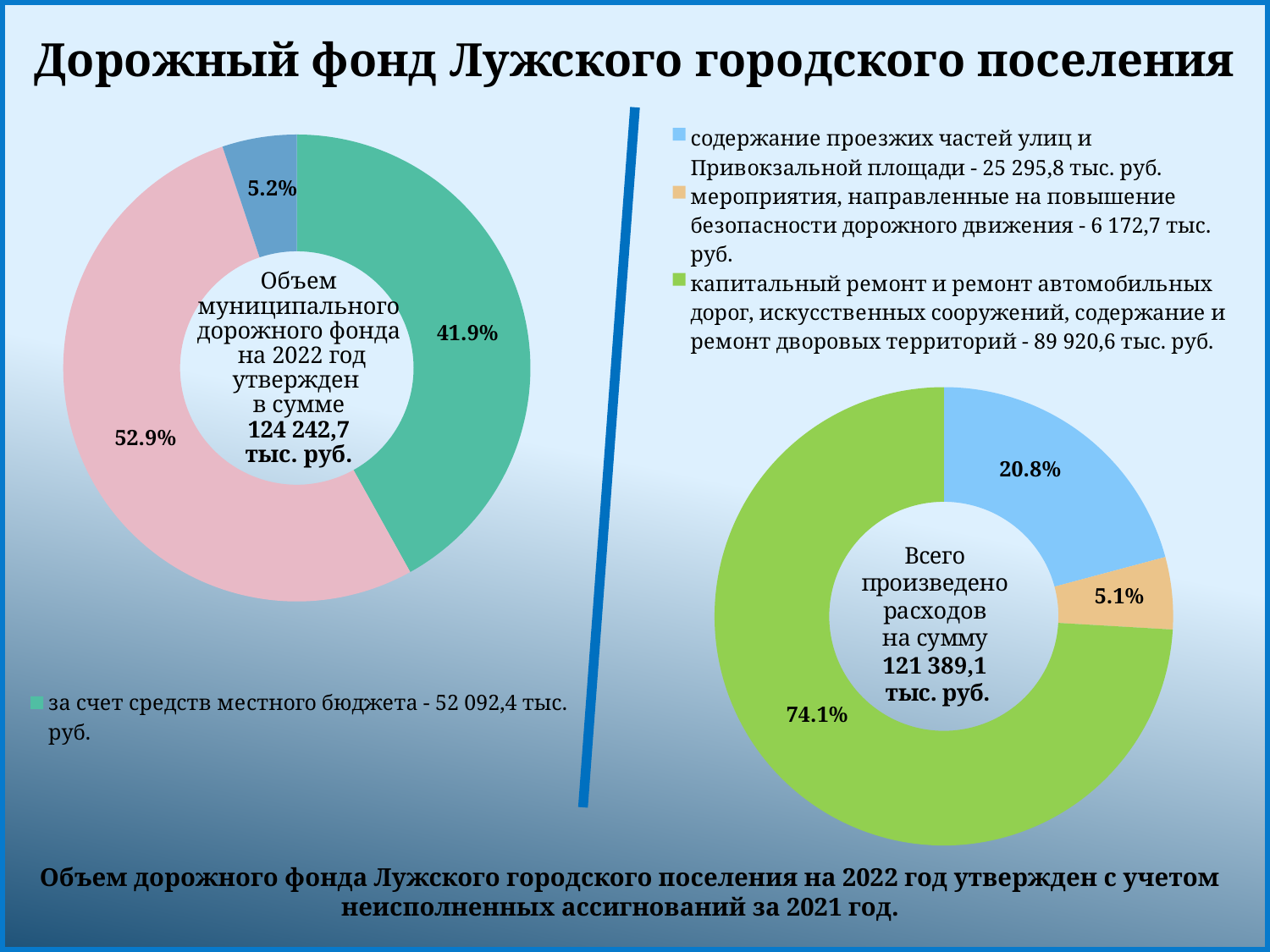
On the right chart (Всего произведено расходов), how many categories does the legend list? 3 On the right chart, what total amount of expenditures is shown in the centre of the chart? 121 389,1 тыс. руб. On the right chart (Всего произведено расходов), by how many percentage points does the share for капитальный ремонт exceed the share for содержание проезжих частей улиц и Привокзальной площади? 53.3 percentage points On the right chart (Всего произведено расходов), which category has the smallest share? мероприятия, направленные на повышение безопасности дорожного движения On the right chart (Всего произведено расходов), what share goes to мероприятия, направленные на повышение безопасности дорожного движения? 5.1% On the left chart (Объем муниципального дорожного фонда на 2022 год), how many slices does the chart have? 3 What kind of chart is the left chart (Объем муниципального дорожного фонда на 2022 год)? Pie (donut) chart On the left chart (Объем муниципального дорожного фонда на 2022 год), what share is attributed to за счет средств местного бюджета? 41.9% On the right chart (Всего произведено расходов), what share goes to содержание проезжих частей улиц и Привокзальной площади? 20.8% On the left chart (Объем муниципального дорожного фонда на 2022 год), what is the largest share shown? 52.9% On the right chart (Всего произведено расходов), which category has the largest share? капитальный ремонт и ремонт автомобильных дорог, искусственных сооружений, содержание и ремонт дворовых территорий